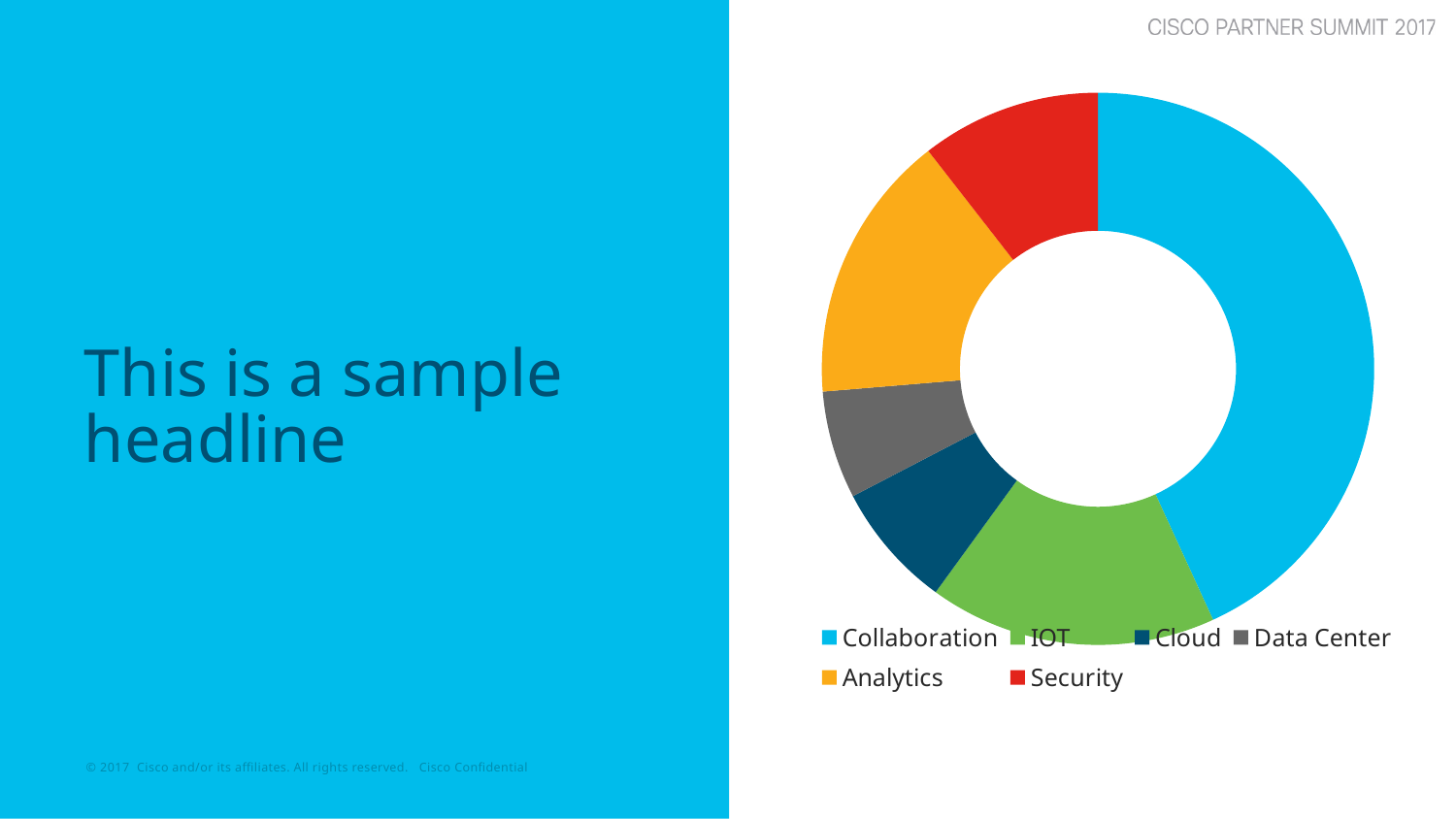
What colour represents Collaboration in the chart? Light blue Which slice is larger, Analytics or Security? Analytics Which category has the largest slice of the doughnut chart? Collaboration How many entries does the chart legend list? 6 Which slice is larger, IOT or Data Center? IOT How many categories does the doughnut chart show? 6 What kind of chart is shown on the slide? Doughnut chart Which slice is larger, Collaboration or Analytics? Collaboration Which category is shown in red on the doughnut chart? Security